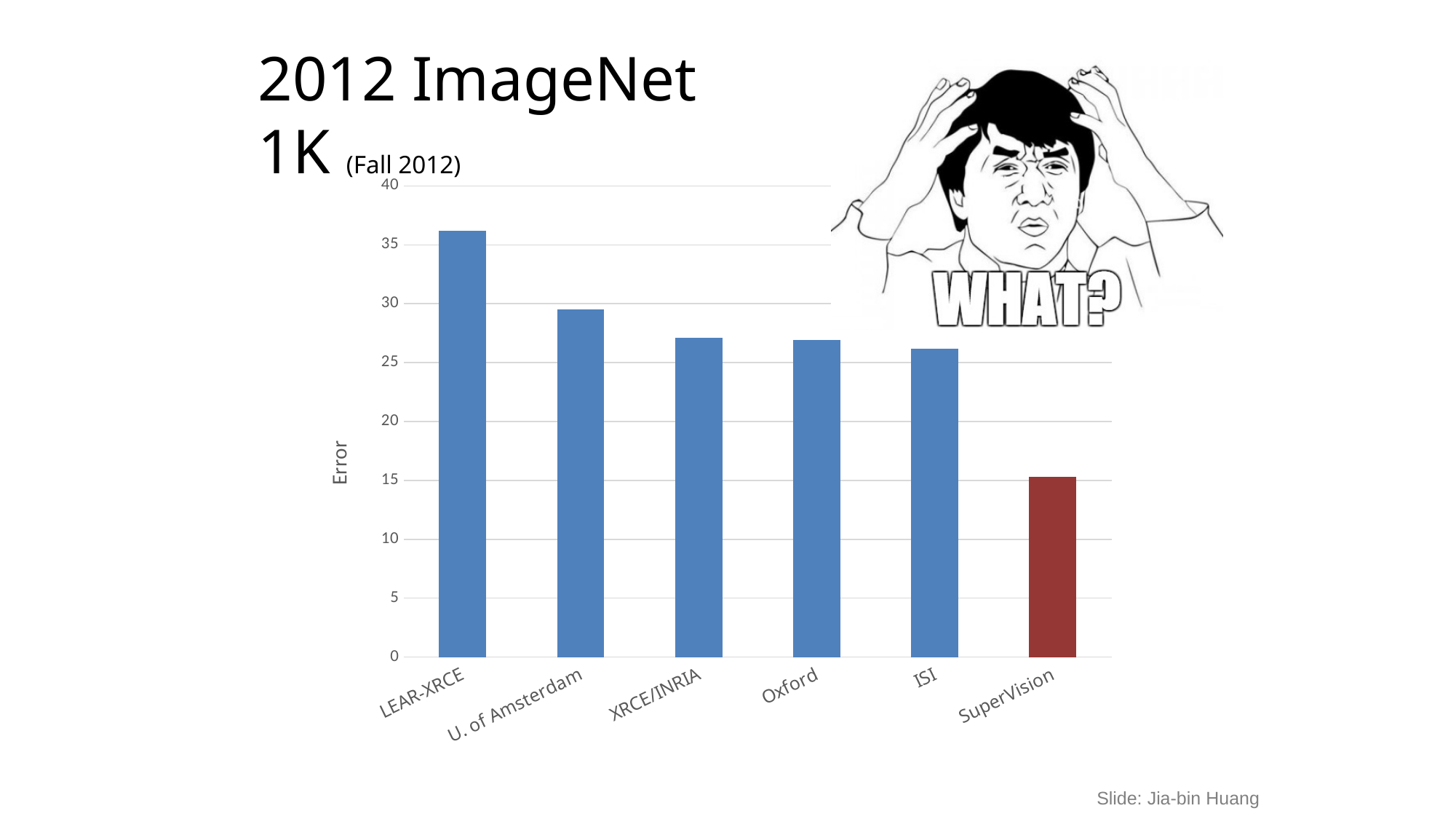
What is the label on the vertical axis of the chart? Error Which has a lower error, ISI or SuperVision? SuperVision Is the error value for U. of Amsterdam greater or less than 30? less Which has a higher error, U. of Amsterdam or Oxford? U. of Amsterdam What kind of chart is shown on the slide? bar chart Which team has the lowest error in the chart? SuperVision Is the error value for ISI greater or less than 25? greater Is the error value for LEAR-XRCE greater or less than 35? greater Do the error values generally rise or fall moving from left to right along the x axis? fall How many categories (teams) are shown on the x axis of the chart? 6 Which team has the highest error in the chart? LEAR-XRCE